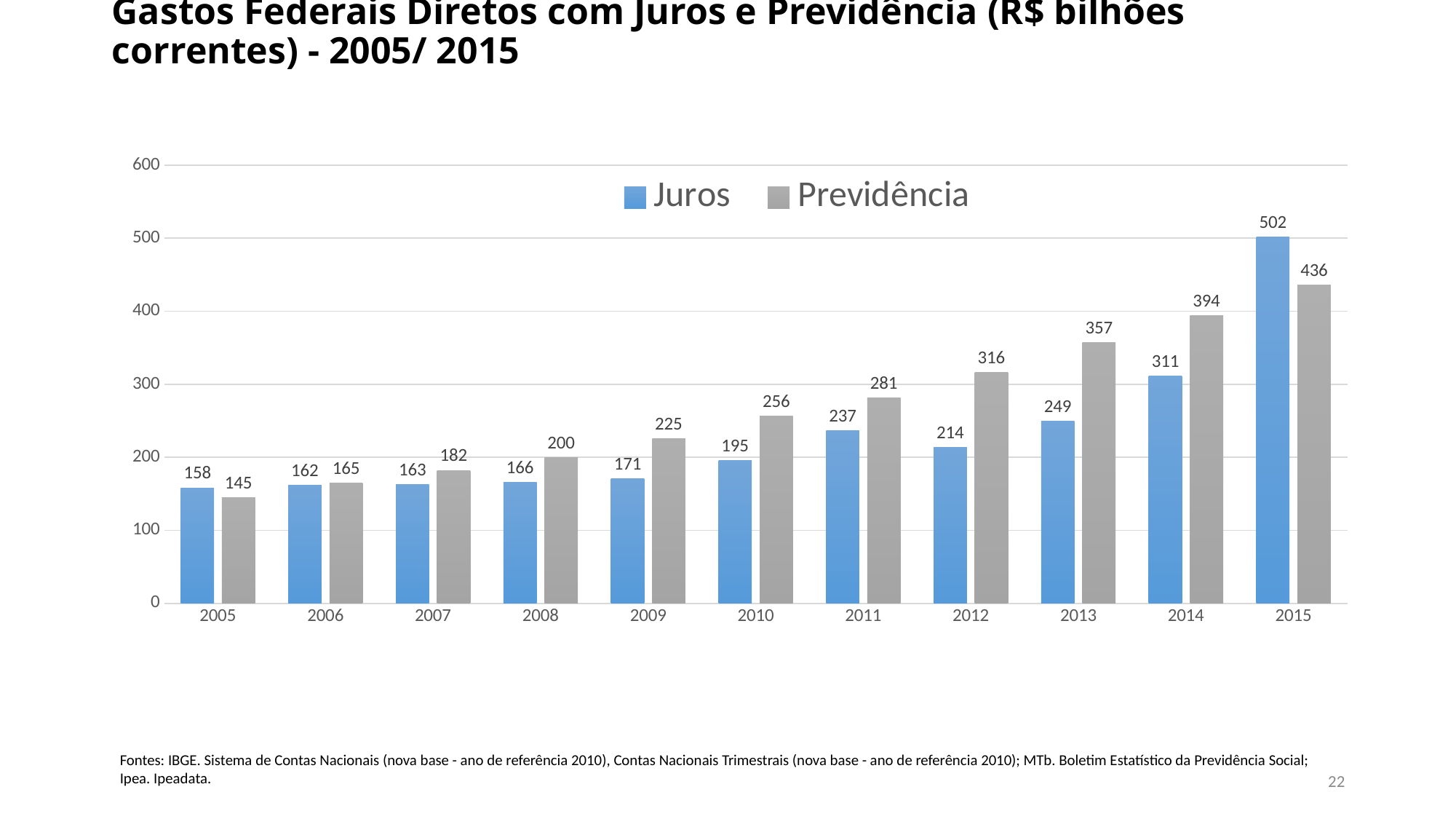
Which year has the highest Previdência value? 2015 Do the Previdência values rise or fall from 2005 to 2015? rise How many series does the legend list? 2 In 2005, which is larger, Juros or Previdência? Juros What is the value of Previdência in 2009? 225 What is the difference between Previdência and Juros in 2014? 83 What is the value of Juros in 2015? 502 Which year has the lowest Previdência value? 2005 What is the value of Juros in 2012? 214 How many years are shown on the x axis? 11 What kind of chart is shown on the slide? bar chart Is the value for Juros in 2013 greater or less than 300? less